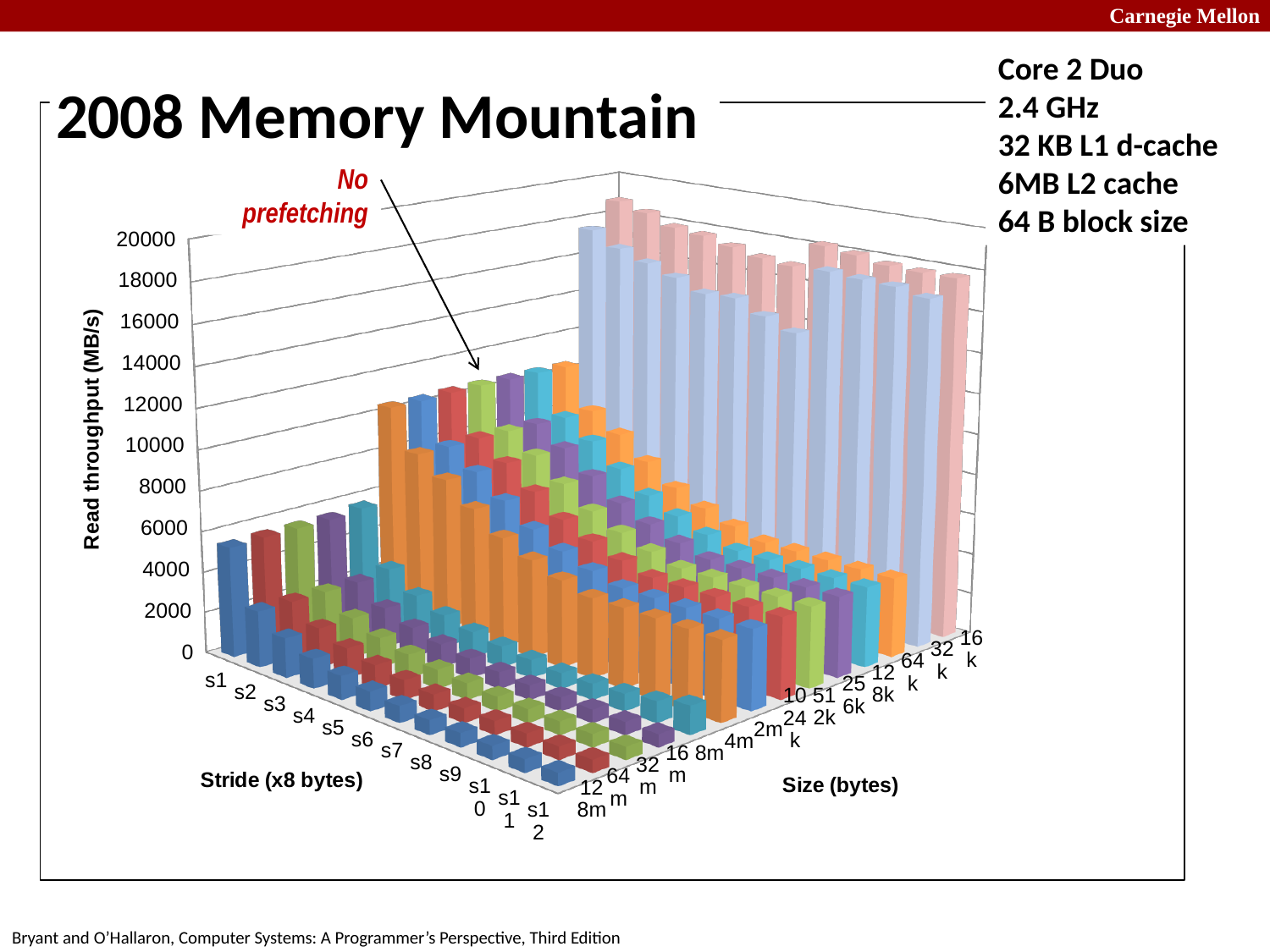
Is the read throughput for stride s1 at size 8m (front row) greater or less than 8000? less Is the read throughput for stride s1 at size 16k greater or less than 14000? greater Which is larger: the read throughput for stride s1 at size 32k or for stride s12 at size 8m? s1 at 32k What is the label of the vertical axis of the chart? Read throughput (MB/s) How many stride categories (s1 through s12) are shown on the stride axis? 12 For the front row (size 8m), does read throughput rise or fall as the stride increases from s1 to s12? fall For the front row (size 8m), which stride has the highest read throughput? s1 What is the title of the chart? 2008 Memory Mountain Is the read throughput for stride s12 at size 8m (front row) greater or less than 4000? less What kind of chart is shown on the slide? bar chart What is the highest tick value shown on the read throughput axis? 20000 Which is larger: the read throughput for stride s1 at size 16k or for stride s1 at size 8m? s1 at 16k